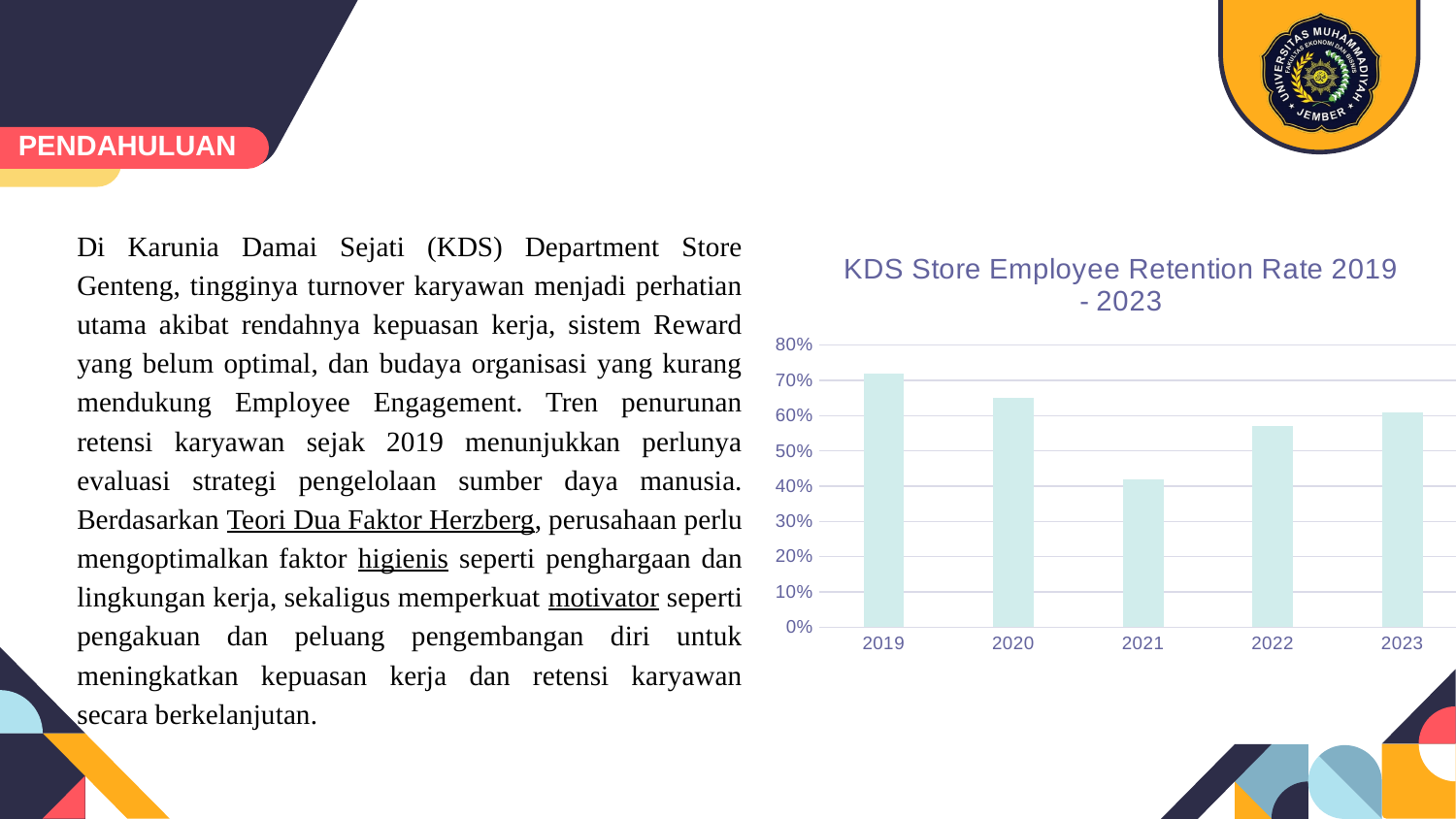
Is the retention rate for 2022 greater or less than 50%? greater Which year has the highest employee retention rate? 2019 Do the retention rate values rise or fall from 2019 to 2021? fall Is the retention rate for 2021 greater or less than 50%? less Is the retention rate for 2019 greater or less than 60%? greater Which year has a higher retention rate, 2020 or 2022? 2020 What is the title of the chart? KDS Store Employee Retention Rate 2019 - 2023 What type of chart is shown on the slide? Bar chart Which year has the lowest employee retention rate? 2021 How many years are shown on the x axis of the chart? 5 Which year has a higher retention rate, 2021 or 2023? 2023